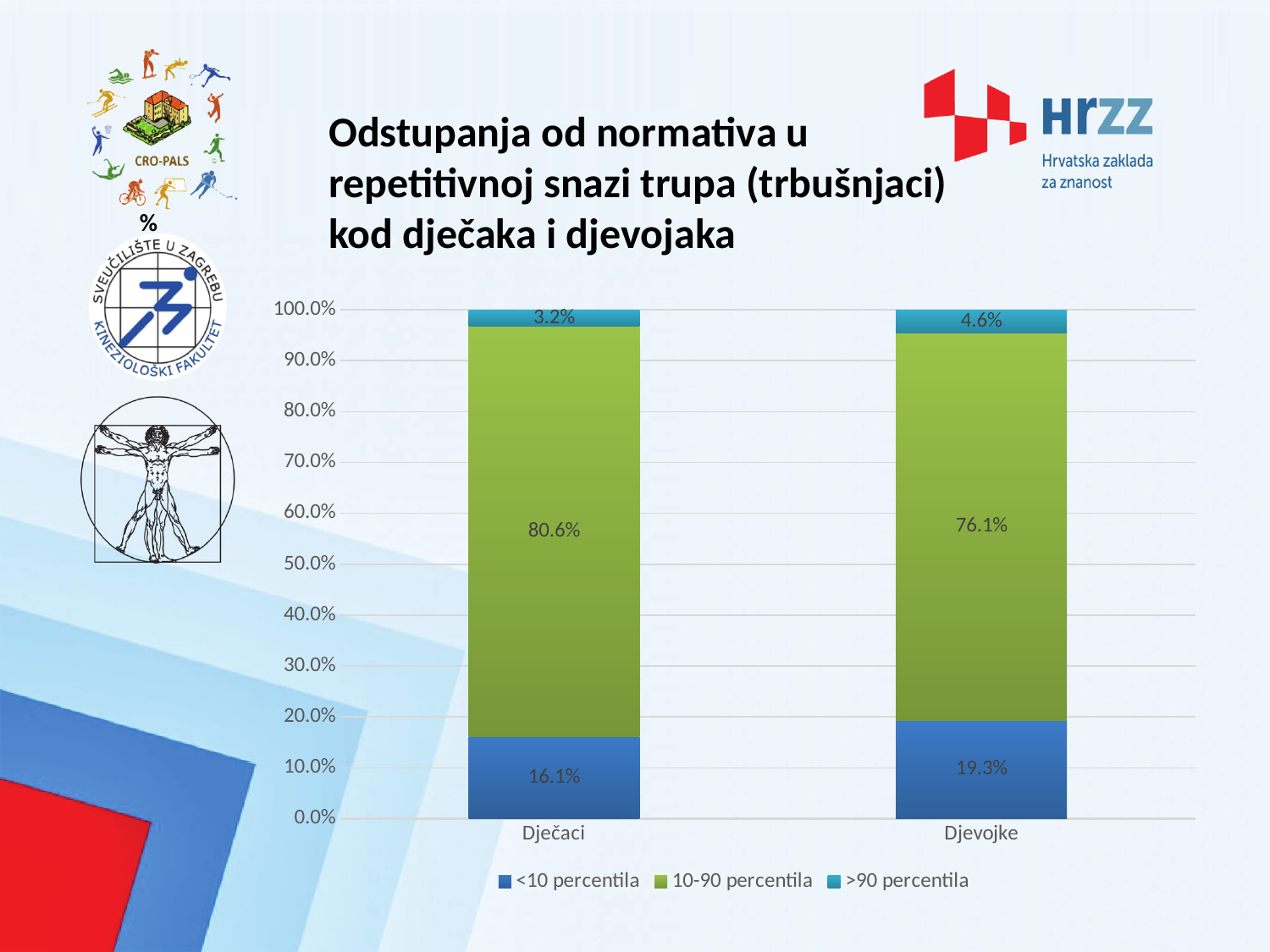
What is the value for '>90 percentila' for Dječaci? 3.2% Which category has the higher value for '10-90 percentila', Dječaci or Djevojke? Dječaci How many categories are shown on the x axis? 2 What is the difference between the '10-90 percentila' values for Dječaci and Djevojke? 4.5% Which series is shown in green in the legend? 10-90 percentila What kind of chart is shown on the slide? Stacked bar chart What is the value for '>90 percentila' for Djevojke? 4.6% What is the value for '<10 percentila' for Dječaci? 16.1% How many series does the legend list? 3 Which category has the lower value for '<10 percentila'? Dječaci What is the value for '10-90 percentila' for Djevojke? 76.1% What is the difference between the '<10 percentila' values for Djevojke and Dječaci? 3.2%